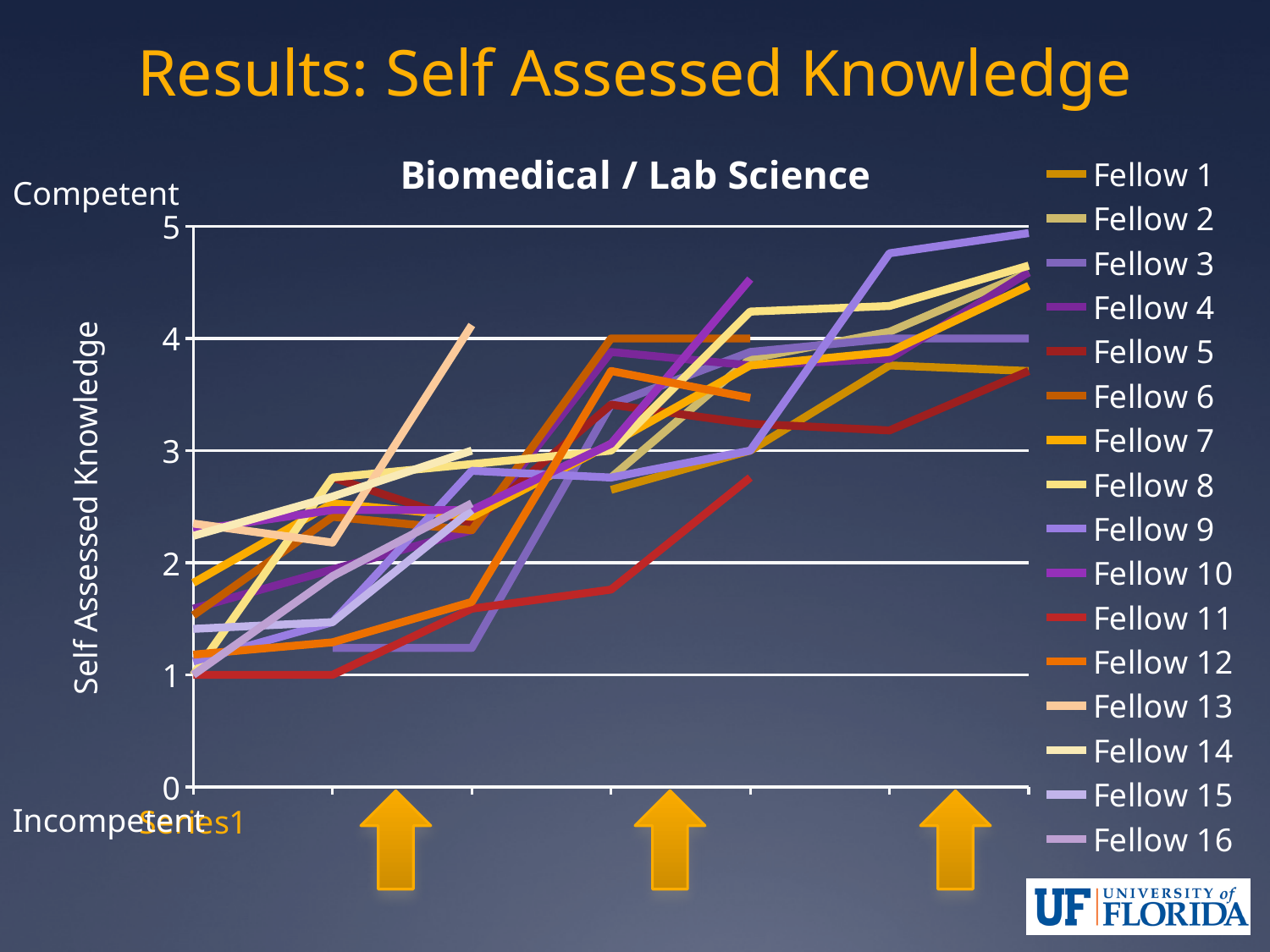
Is the highest value reached by any line at the right end of the chart greater or less than 4? greater What is the label on the vertical axis of the chart? Self Assessed Knowledge Do the lines generally rise or fall from left to right along the x axis? rise What kind of chart is shown on the slide? line chart What is the title of the chart? Biomedical / Lab Science Is the lowest value among the lines at the first point on the x axis greater or less than 2? less Is the value for every fellow at the first point on the x axis greater or less than 3? less How many series does the legend list? 16